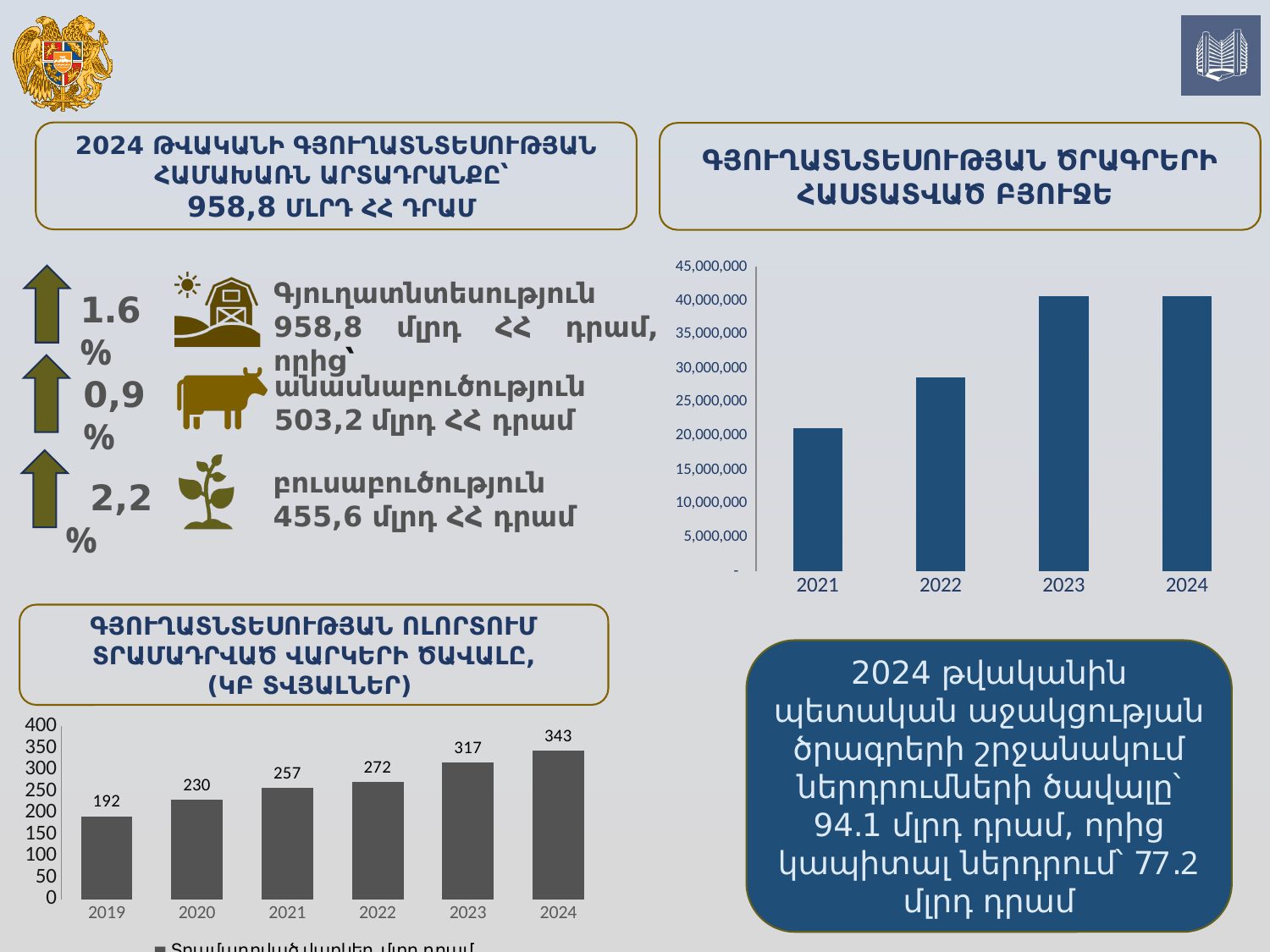
In the bar chart at the bottom left of the slide, do the values rise or fall from 2019 to 2024? rise In the bar chart at the bottom left of the slide, what is the value for 2023? 317 In the bar chart at the top right of the slide, is the value for 2021 greater or less than 20,000,000? greater In the bar chart at the bottom left of the slide, how many years are shown? 6 In the bar chart at the bottom left of the slide, what is the value for 2019? 192 In the bar chart at the top right of the slide, is the value for 2022 greater or less than 30,000,000? less In the bar chart at the bottom left of the slide, which year has the highest value? 2024 What kind of chart is shown at the top right of the slide? bar chart In the bar chart at the bottom left of the slide, what is the difference between the values for 2022 and 2021? 15 In the bar chart at the bottom left of the slide, what is the difference between the values for 2024 and 2019? 151 In the bar chart at the top right of the slide, which year has the lowest value? 2021 In the bar chart at the bottom left of the slide, which year has the lowest value? 2019